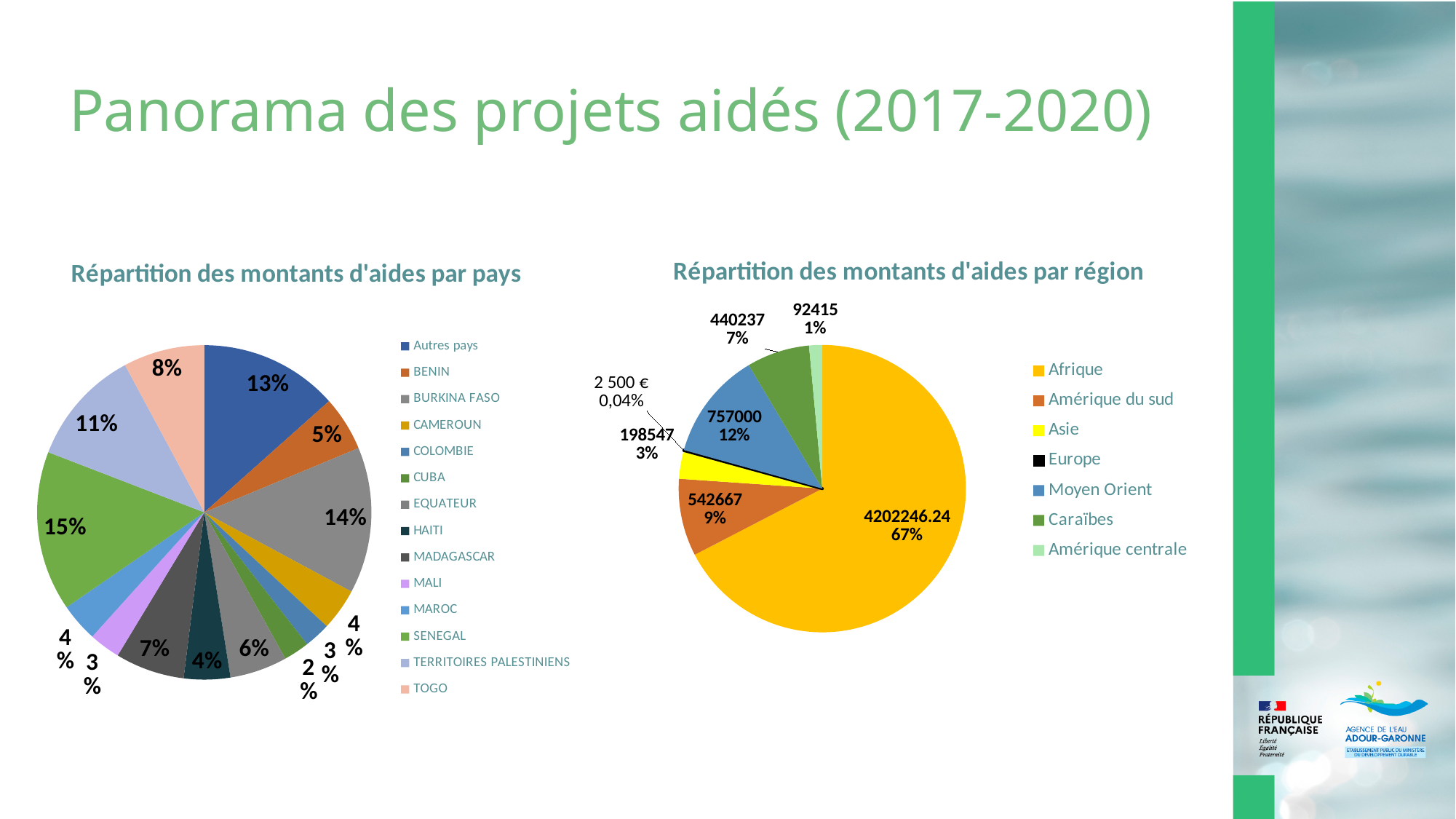
In the chart 'Répartition des montants d'aides par région', what amount is shown for Moyen Orient? 757000 In the chart 'Répartition des montants d'aides par région', which region has the smallest slice? Europe How many categories does the legend of the chart 'Répartition des montants d'aides par pays' list? 14 What type of chart is 'Répartition des montants d'aides par pays'? Pie chart In the chart 'Répartition des montants d'aides par région', what is the difference between the amounts for Moyen Orient and Amérique du sud? 214333 In the chart 'Répartition des montants d'aides par pays', what share does TERRITOIRES PALESTINIENS have? 11% In the chart 'Répartition des montants d'aides par région', which is larger, the amount for Caraïbes or the amount for Asie? Caraïbes In the chart 'Répartition des montants d'aides par région', what percentage share does Afrique have? 67% In the chart 'Répartition des montants d'aides par pays', what share does TOGO have? 8% In the chart 'Répartition des montants d'aides par pays', which country has the largest share? SENEGAL How many regions does the legend of the chart 'Répartition des montants d'aides par région' list? 7 In the chart 'Répartition des montants d'aides par région', which region has the largest slice? Afrique